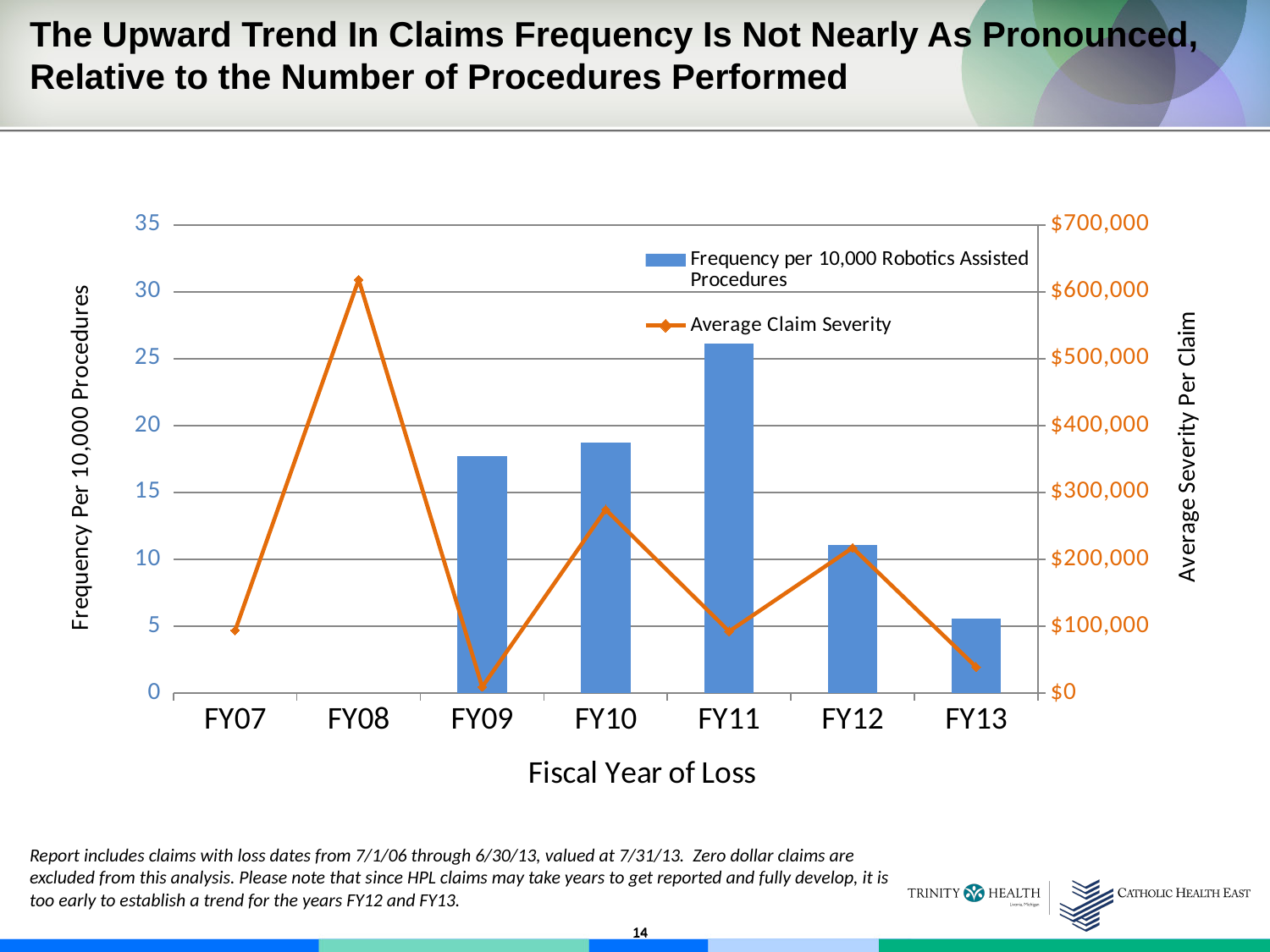
How many fiscal years are shown on the x axis? 7 Which is larger, the Frequency per 10,000 Robotics Assisted Procedures bar for FY12 or for FY13? FY12 Is the Average Claim Severity for FY08 greater or less than $600,000? greater What is the title of the right-hand vertical axis? Average Severity Per Claim Which fiscal year has the lowest Average Claim Severity? FY09 Does the Frequency per 10,000 Robotics Assisted Procedures rise or fall from FY11 to FY13? Fall Is the Frequency per 10,000 Robotics Assisted Procedures for FY11 greater or less than 25? greater Which fiscal year has the highest Frequency per 10,000 Robotics Assisted Procedures bar? FY11 What kind of chart is shown on the slide? A combined bar and line chart Which fiscal year has the highest Average Claim Severity? FY08 How many series does the legend list? 2 Is the Frequency per 10,000 Robotics Assisted Procedures for FY13 greater or less than 10? less